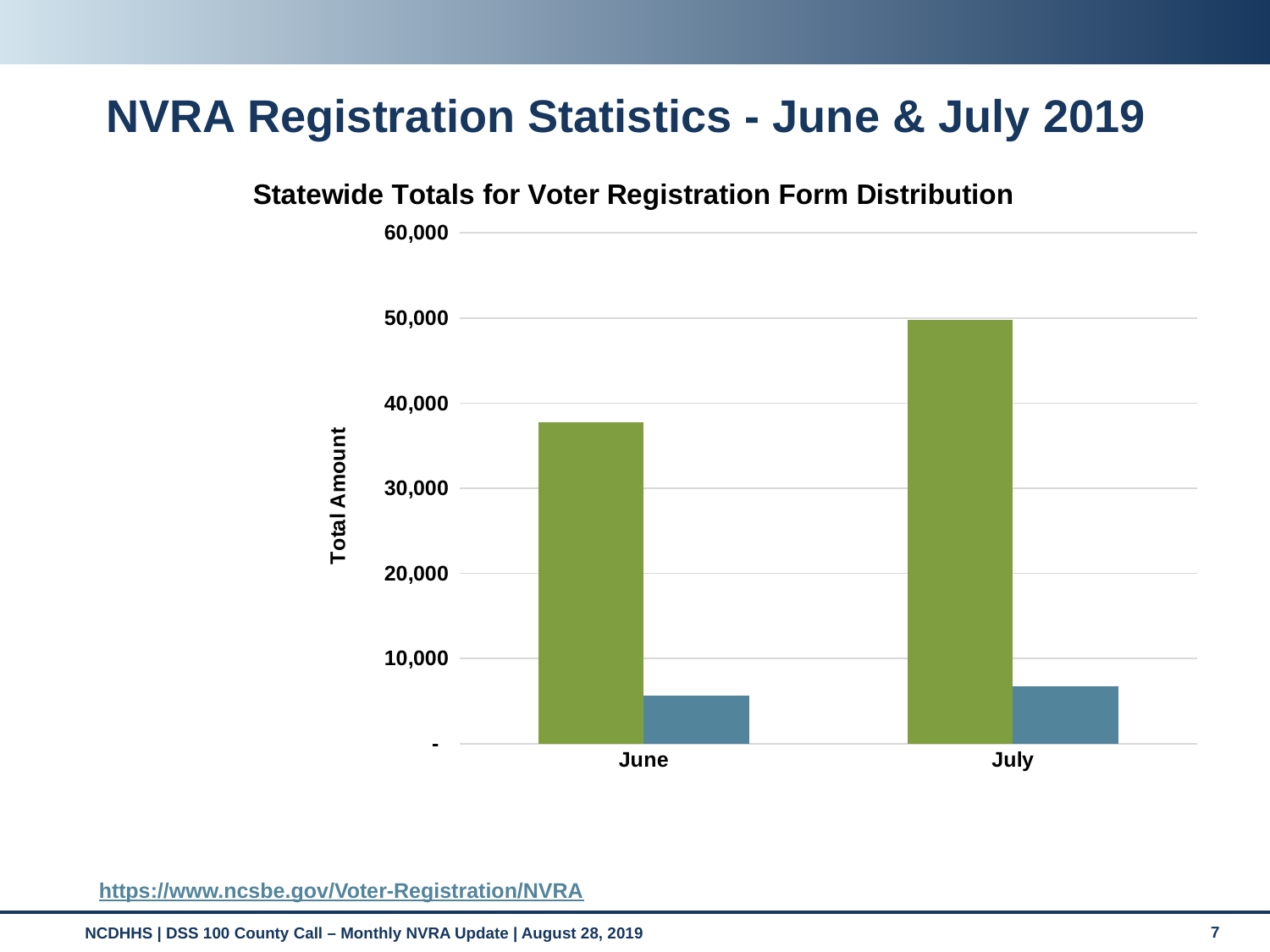
How many categories are shown on the x axis of the chart? 2 What is the label on the vertical axis of the chart? Total Amount Which bar is the tallest in the chart? the green bar for July Is the value of the green bar for July greater or less than 40,000? greater Is the value of the green bar for June greater or less than 40,000? less What is the title of the chart? Statewide Totals for Voter Registration Form Distribution Is the value of the blue bar for June greater or less than 10,000? less Which month has the taller green bar, June or July? July What kind of chart is shown on the slide? bar chart Do the green bars rise or fall from June to July? rise